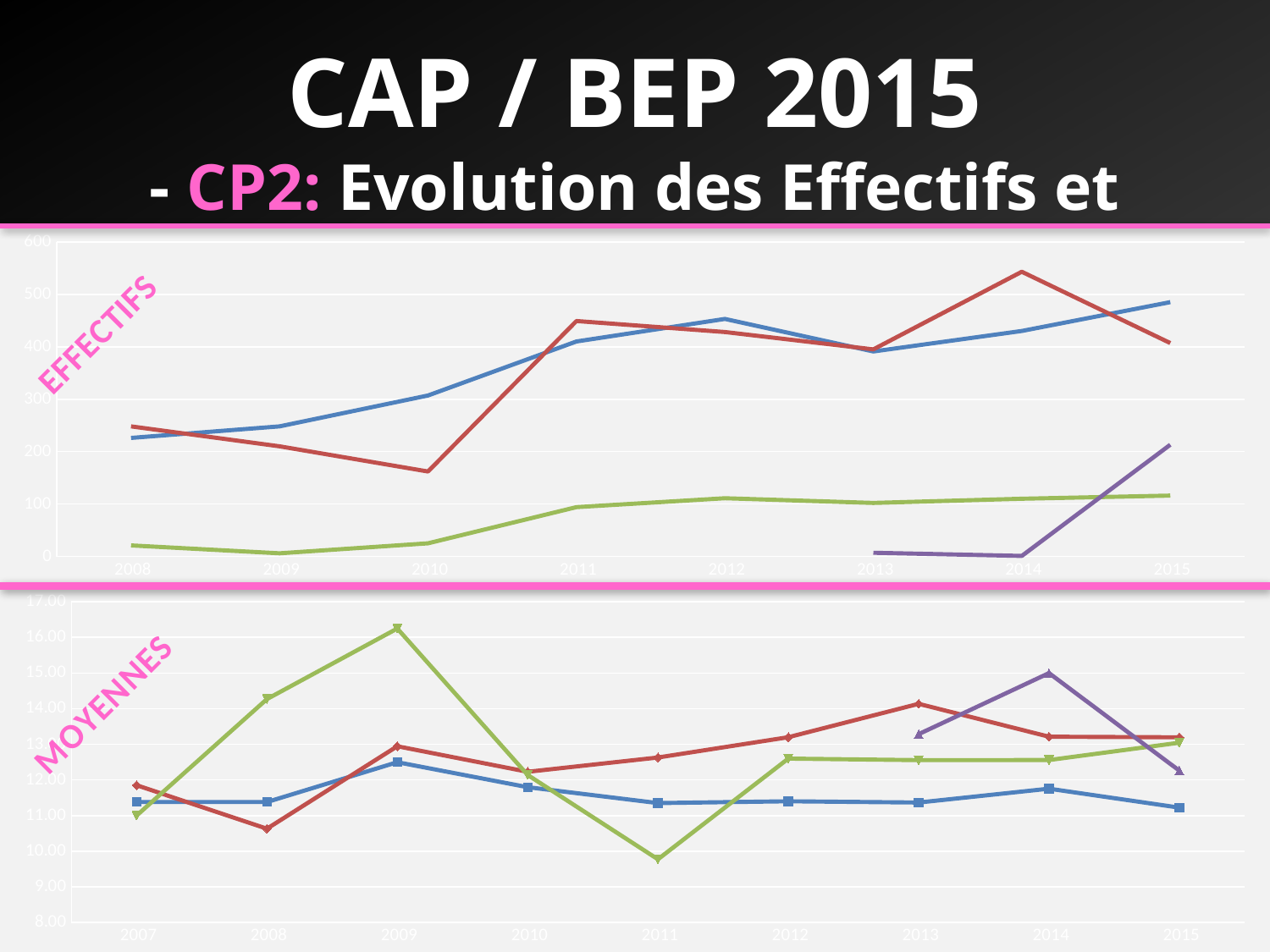
In the top chart (EFFECTIFS), how many years are shown on the x axis? 8 In the top chart (EFFECTIFS), in which year does the red line reach its highest value? 2014 In the bottom chart (MOYENNES), how many years are shown on the x axis? 9 In the top chart (EFFECTIFS), how many lines are plotted? 4 What kind of chart is the top chart labelled EFFECTIFS? Line chart In the top chart (EFFECTIFS), in 2014, which line is higher: the red line or the blue line? Red In the top chart (EFFECTIFS), is the value of the red line in 2010 greater or less than 200? less In the bottom chart (MOYENNES), is the value of the green line in 2009 greater or less than 16.00? greater In the top chart (EFFECTIFS), does the blue line generally rise or fall from 2008 to 2015? Rise In the top chart (EFFECTIFS), is the value of the blue line in 2015 greater or less than 400? greater What kind of chart is the bottom chart labelled MOYENNES? Line chart In the bottom chart (MOYENNES), in which year does the green line reach its lowest value? 2011